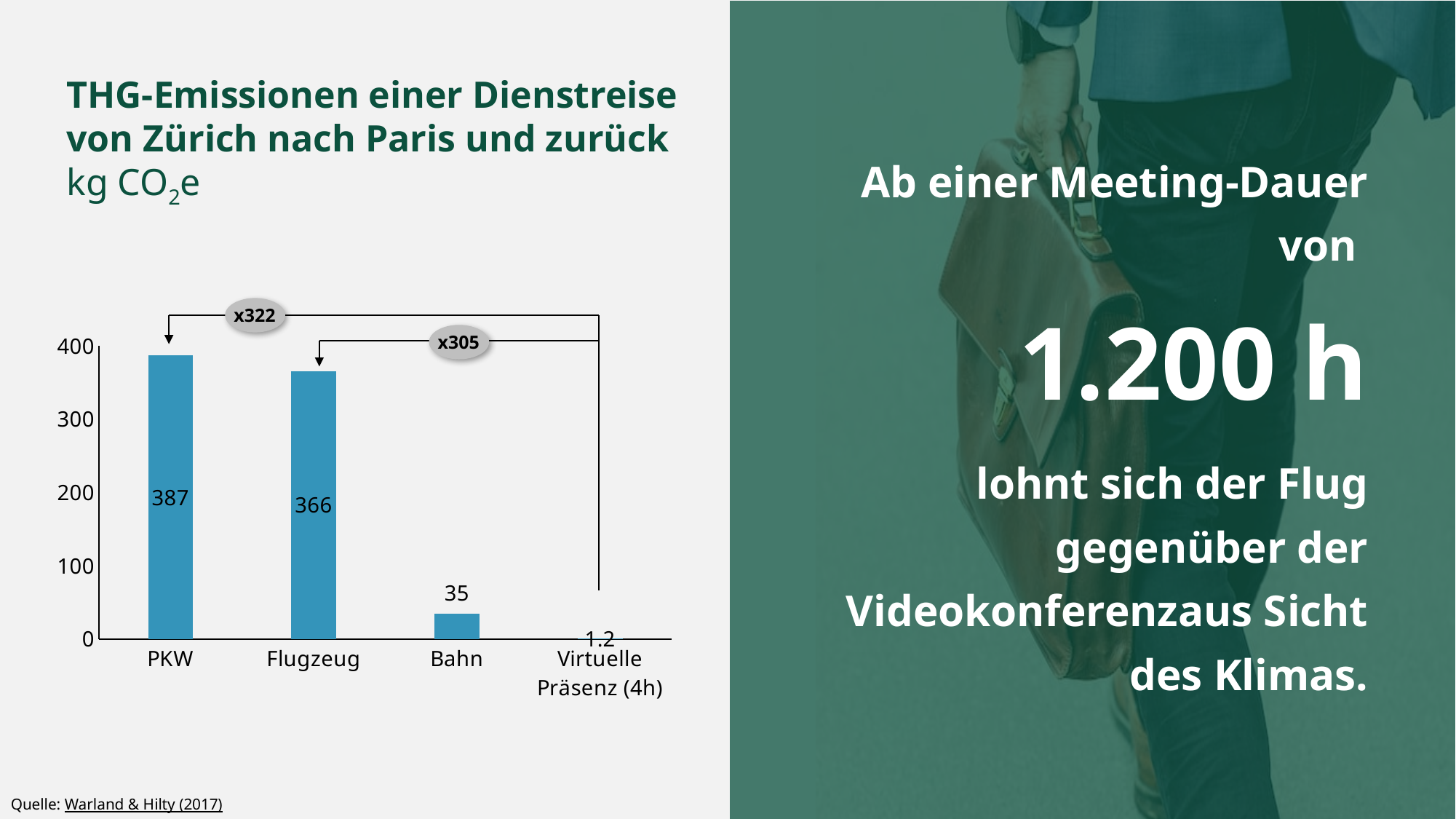
Which is larger, the value for Bahn or the value for Flugzeug? Flugzeug What is the value for Bahn? 35 Which category has the lowest value? Virtuelle Präsenz (4h) What is the difference between the values for PKW and Flugzeug? 21 What is the value for Virtuelle Präsenz (4h)? 1.2 What is the value for PKW? 387 What unit is given below the chart title? kg CO2e What is the difference between the values for Flugzeug and Bahn? 331 What kind of chart is shown on the slide? bar chart What is the value for Flugzeug? 366 How many categories are shown on the x axis? 4 Which category has the highest value? PKW